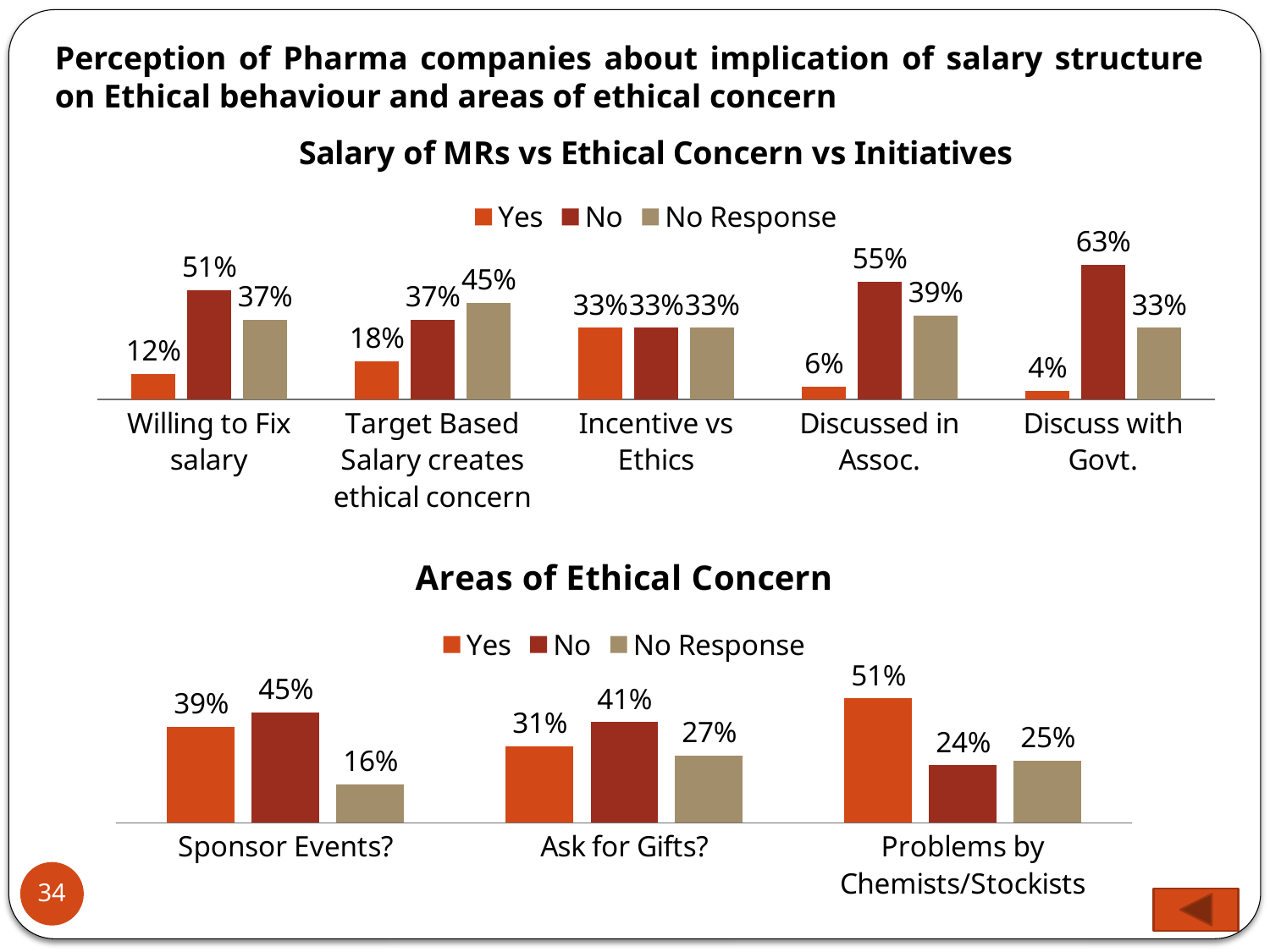
In the 'Areas of Ethical Concern' chart, what is the 'No Response' value for 'Sponsor Events?'? 16% What kind of chart is the 'Areas of Ethical Concern' chart? Bar chart In the 'Salary of MRs vs Ethical Concern vs Initiatives' chart, how many categories are shown on the x axis? 5 In the 'Areas of Ethical Concern' chart, which category has the highest 'Yes' value? Problems by Chemists/Stockists In the 'Salary of MRs vs Ethical Concern vs Initiatives' chart, what is the 'No' value for 'Discuss with Govt.'? 63% In the 'Salary of MRs vs Ethical Concern vs Initiatives' chart, what is the 'Yes' value for 'Willing to Fix salary'? 12% In the 'Salary of MRs vs Ethical Concern vs Initiatives' chart, which category has the lowest 'Yes' value? Discuss with Govt. In the 'Areas of Ethical Concern' chart, what colour represents the 'No Response' series? Tan/beige In the 'Salary of MRs vs Ethical Concern vs Initiatives' chart, what is the difference between the 'No' and 'Yes' values for 'Discussed in Assoc.'? 49% In the 'Areas of Ethical Concern' chart, what is the difference between the 'Yes' and 'No' values for 'Problems by Chemists/Stockists'? 27% In the 'Areas of Ethical Concern' chart, which is larger for 'Ask for Gifts?': the 'Yes' value or the 'No' value? No In the 'Salary of MRs vs Ethical Concern vs Initiatives' chart, how many series does the legend list? 3